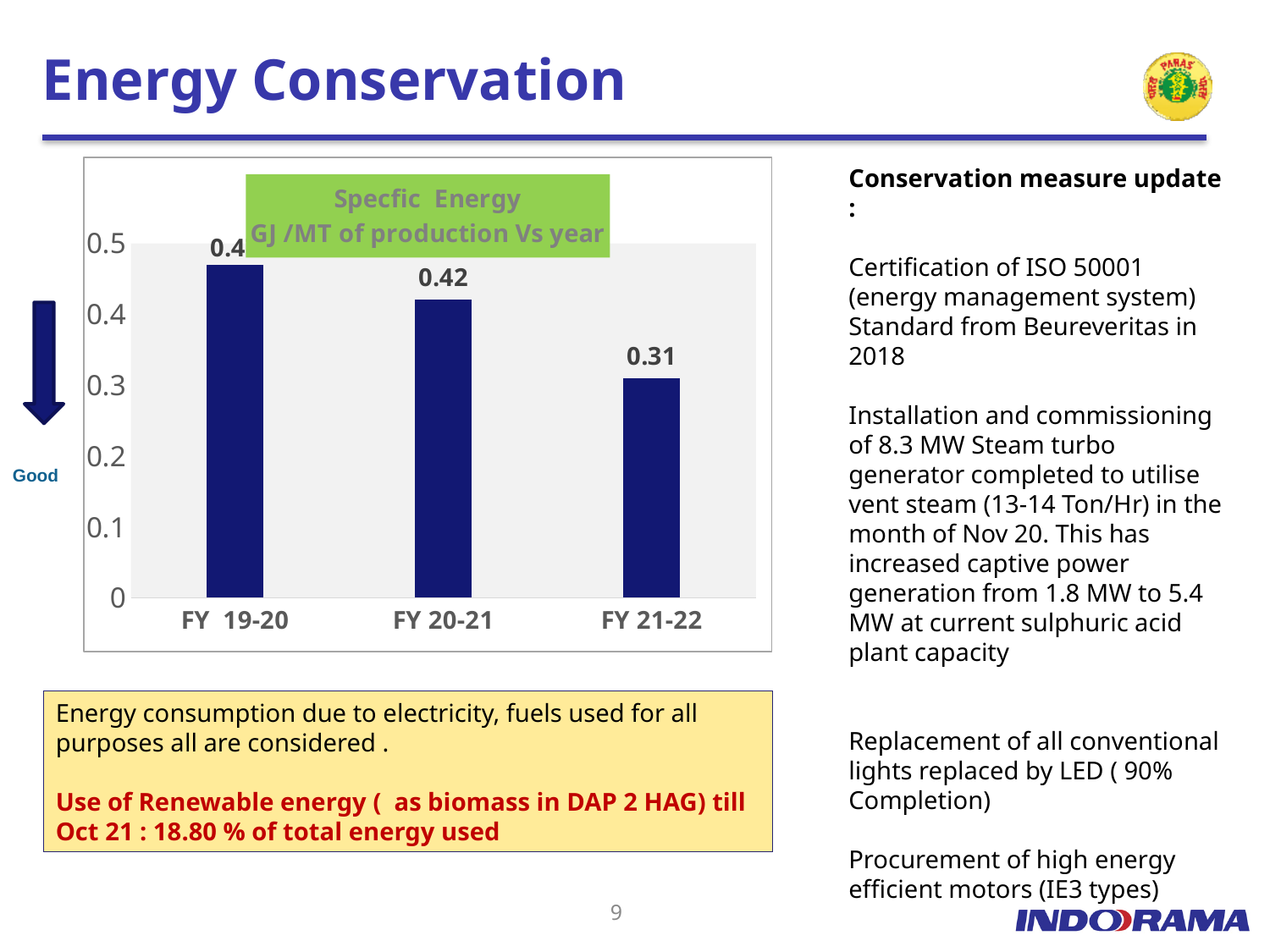
Do the specific energy values rise or fall from FY 19-20 to FY 21-22? fall What is the specific energy value for FY 21-22? 0.31 Is the value for FY 21-22 greater or less than 0.4? less Which is larger, the value for FY 20-21 or the value for FY 21-22? FY 20-21 What is the difference between the specific energy values for FY 20-21 and FY 21-22? 0.11 Is the value for FY 19-20 greater or less than 0.4? greater What unit is given in the chart title for specific energy? GJ /MT of production What type of chart is shown on the slide? bar chart Which fiscal year has the highest specific energy value? FY 19-20 What is the specific energy value for FY 20-21? 0.42 How many fiscal years are plotted in the chart? 3 Which fiscal year has the lowest specific energy value? FY 21-22